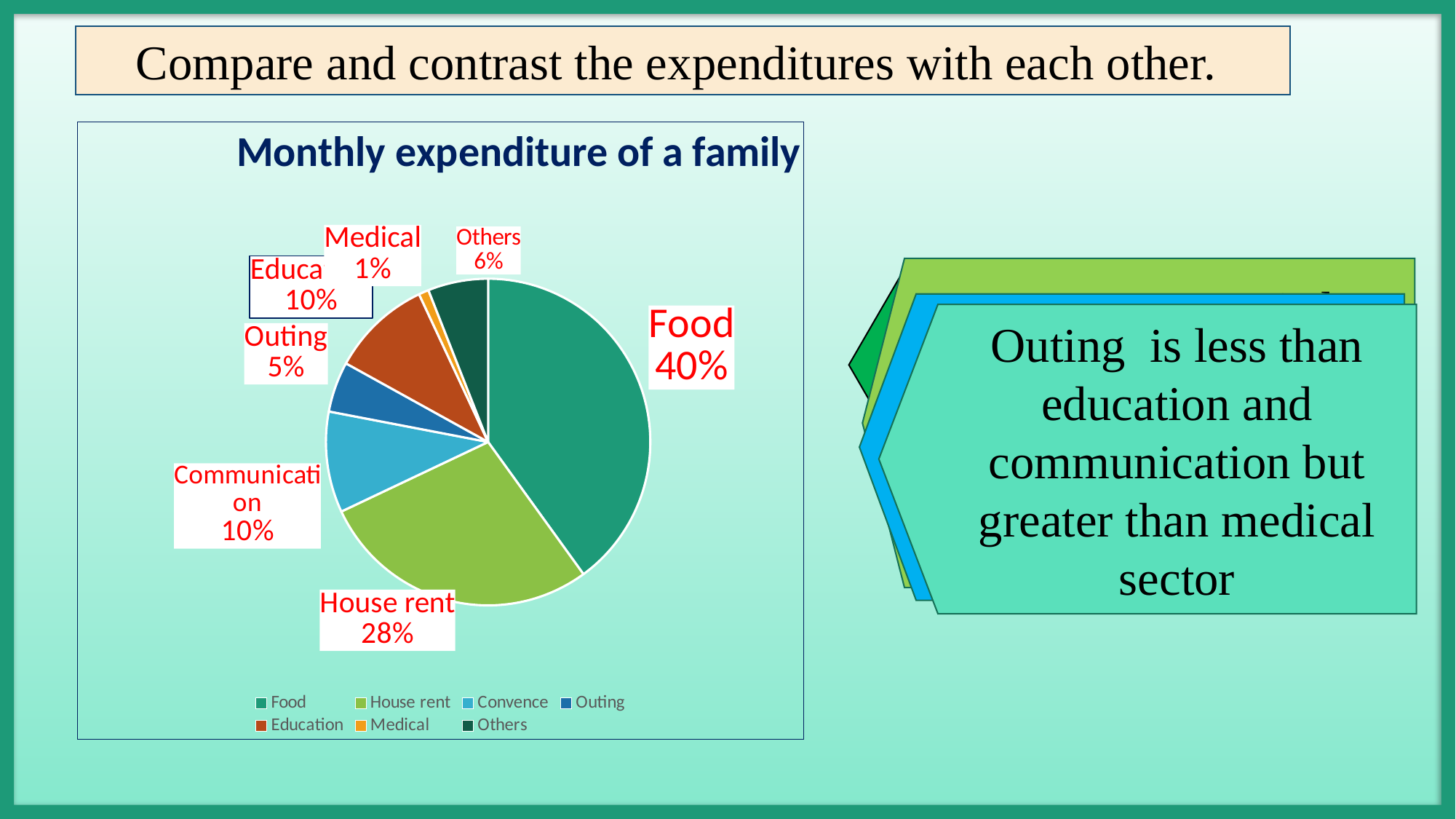
What is the difference in percentage points between Food and House rent? 12 What is the difference in percentage points between Education and Outing? 5 Which category has the largest share of the monthly expenditure? Food What type of chart is shown on the slide? Pie chart Which category has the smallest share of the monthly expenditure? Medical Which is larger, the share for Outing or the share for Others? Others What is the title of the chart? Monthly expenditure of a family How many slices does the pie chart have? 7 What percentage is shown for Others? 6% What percentage is shown for Medical? 1% What percentage of the monthly expenditure is House rent? 28% What share of the monthly expenditure goes to Food? 40%